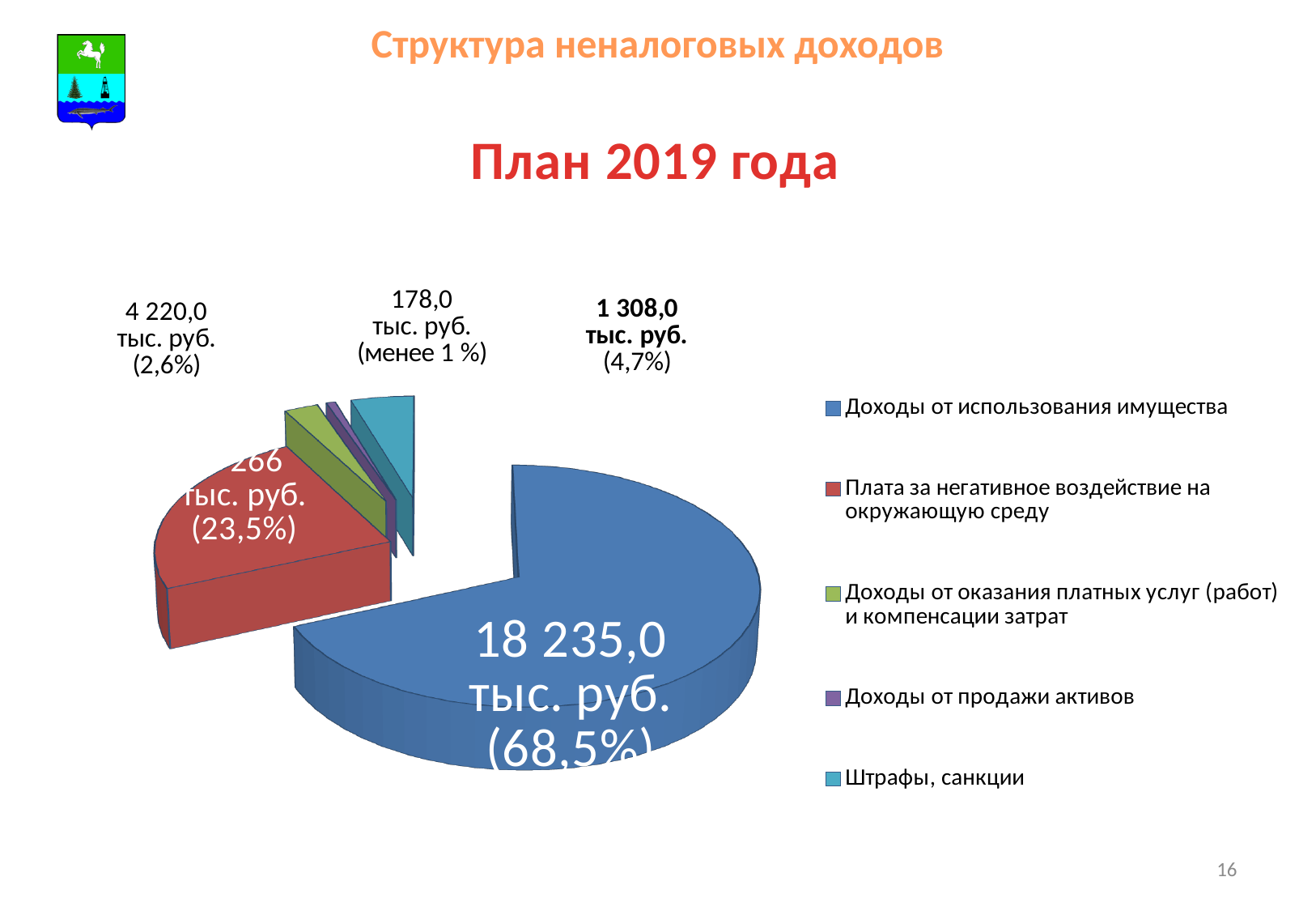
What share of the pie does «Плата за негативное воздействие на окружающую среду» make up? 23,5% Which is larger: «Штрафы, санкции» or «Доходы от продажи активов»? Штрафы, санкции What kind of chart is shown on the slide? Pie chart What is the value shown for «Доходы от использования имущества»? 18 235,0 тыс. руб. Which category has the largest slice of the pie? Доходы от использования имущества Which category has the smallest slice of the pie? Доходы от продажи активов What share of the pie does «Доходы от оказания платных услуг (работ) и компенсации затрат» make up? 2,6% How many slices does the pie chart have? 5 What is the value shown for «Штрафы, санкции»? 1 308,0 тыс. руб. What is the difference between the values for «Доходы от использования имущества» and «Штрафы, санкции»? 16 927,0 тыс. руб. What share of the pie does «Доходы от использования имущества» make up? 68,5% How many entries does the legend list? 5